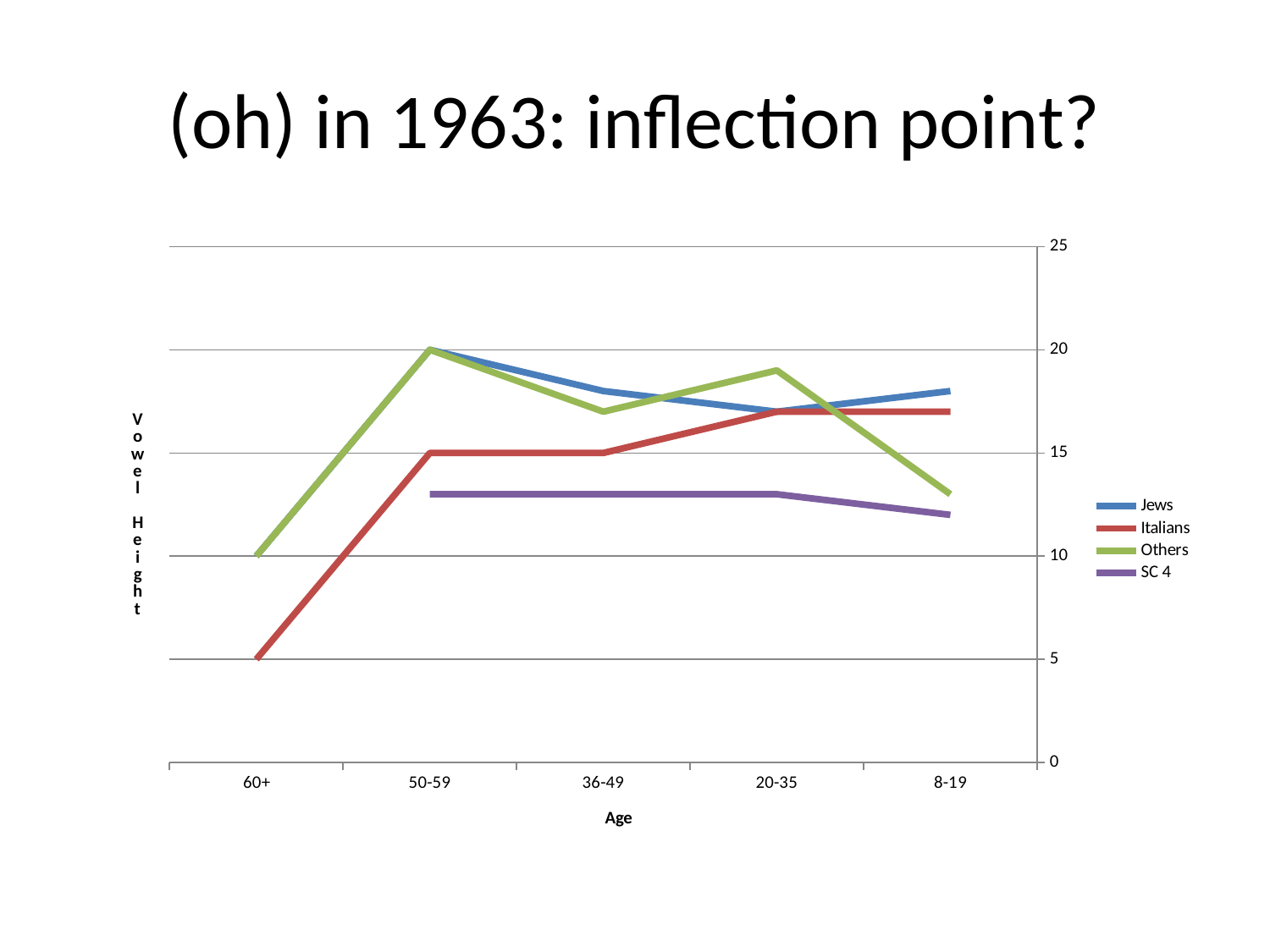
Does the Italians line rise or fall from the 60+ group to the 50-59 group? rise Is the value for Others in the 20-35 age group greater or less than 20? less What kind of chart is shown on the slide? line chart What is the title of the slide? (oh) in 1963: inflection point? What is the vowel height value for Others in the 60+ age group? 10 What is the vowel height value for Italians in the 50-59 age group? 15 Which series has the lowest value in the 50-59 age group? SC 4 How many age categories are shown on the x axis? 5 How many series does the legend list? 4 What is the difference between the Jews and Italians values in the 50-59 age group? 5 What is the vowel height value for Jews in the 50-59 age group? 20 Is the value for SC 4 in the 8-19 age group greater or less than 10? greater